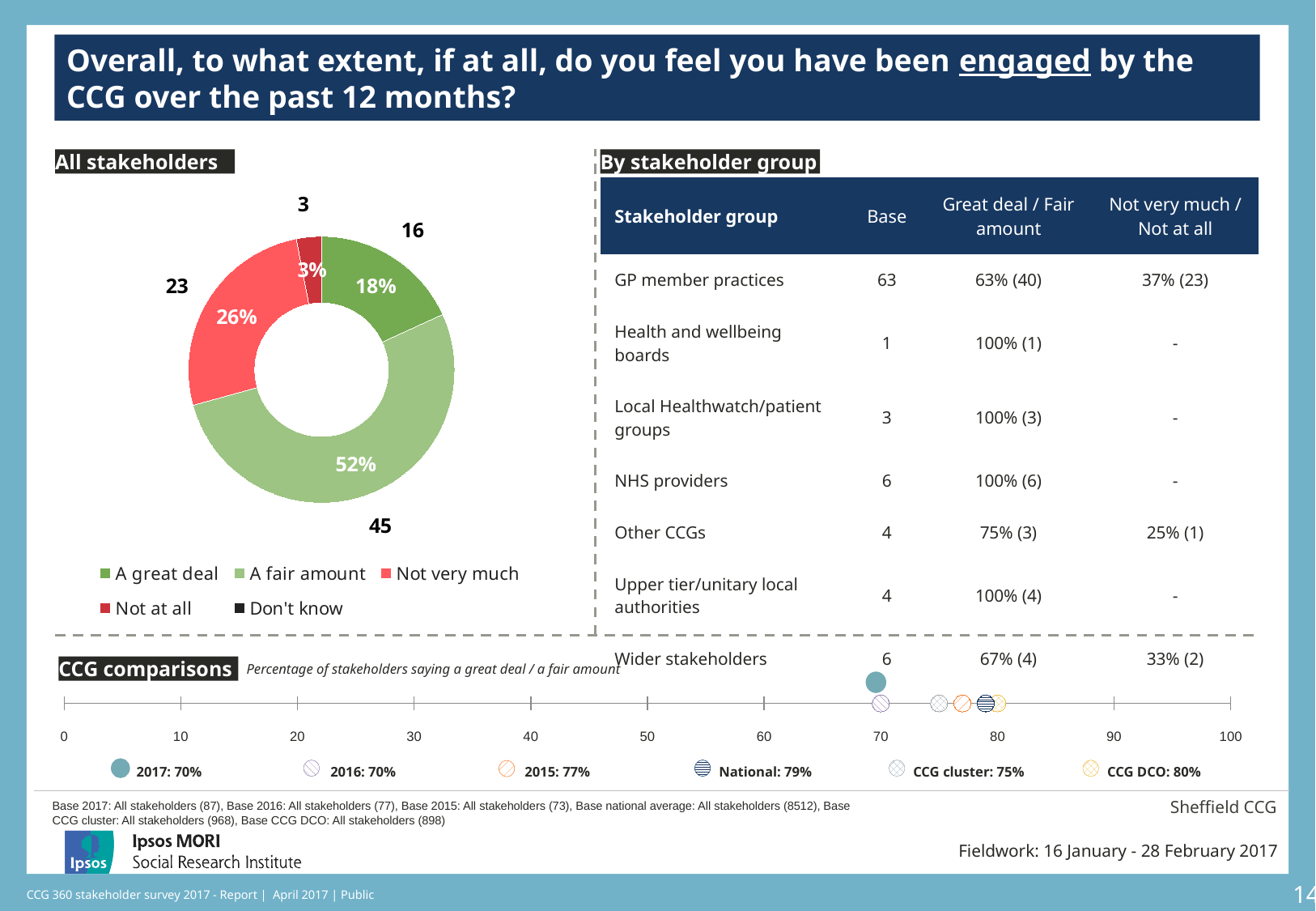
In the All stakeholders donut chart, what is the difference in percentage points between 'A fair amount' and 'Not very much'? 26 percentage points In the All stakeholders donut chart, which response category has the largest share? A fair amount How many entries does the legend of the All stakeholders chart list? 5 In the All stakeholders donut chart, what percentage of stakeholders said 'A fair amount'? 52% In the CCG comparisons chart, what percentage of stakeholders said a great deal / a fair amount in 2015? 77% In the All stakeholders donut chart, which of the labelled slices has the smallest share? Not at all In the All stakeholders donut chart, which is larger: 'A great deal' or 'Not very much'? Not very much What type of chart is the All stakeholders chart? Pie chart (donut) In the CCG comparisons chart, which comparator has the highest percentage? CCG DCO: 80% In the All stakeholders donut chart, what percentage of stakeholders said 'Not very much'? 26% In the All stakeholders donut chart, what is the count shown next to the 'A fair amount' slice? 45 In the All stakeholders donut chart, what percentage of stakeholders said 'A great deal'? 18%